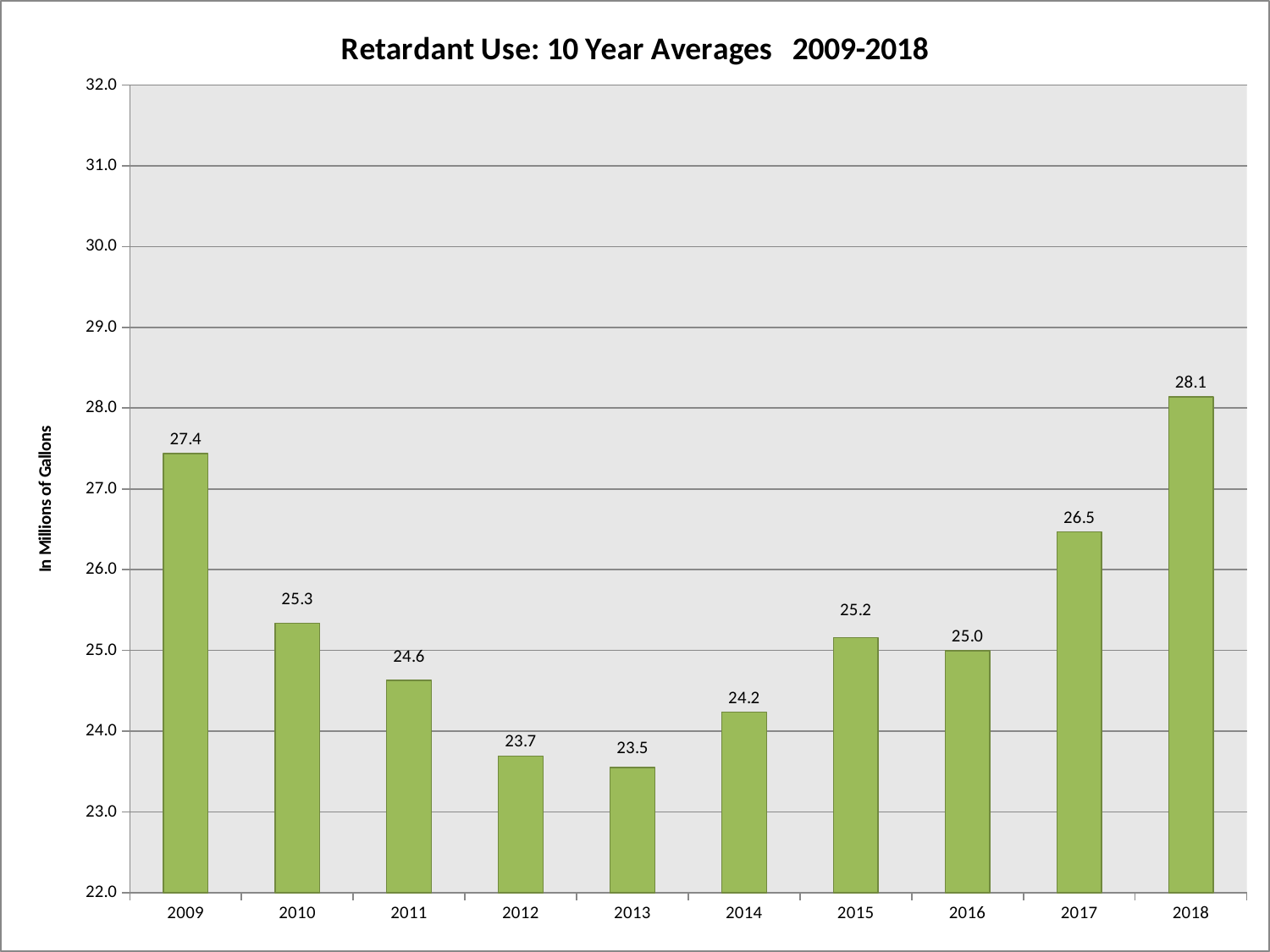
Which is larger, the value for 2011 or the value for 2015? 2015 What is the value for 2017? 26.5 What kind of chart is this? bar chart What is the value for 2009? 27.4 What is the label on the vertical axis? In Millions of Gallons Is the value for 2016 greater or less than 26.0? less Which year has the highest value? 2018 Which year has the lowest value? 2013 What is the difference between the values for 2018 and 2009? 0.7 What is the difference between the values for 2010 and 2012? 1.6 How many years are shown on the x axis? 10 What is the value for 2013? 23.5